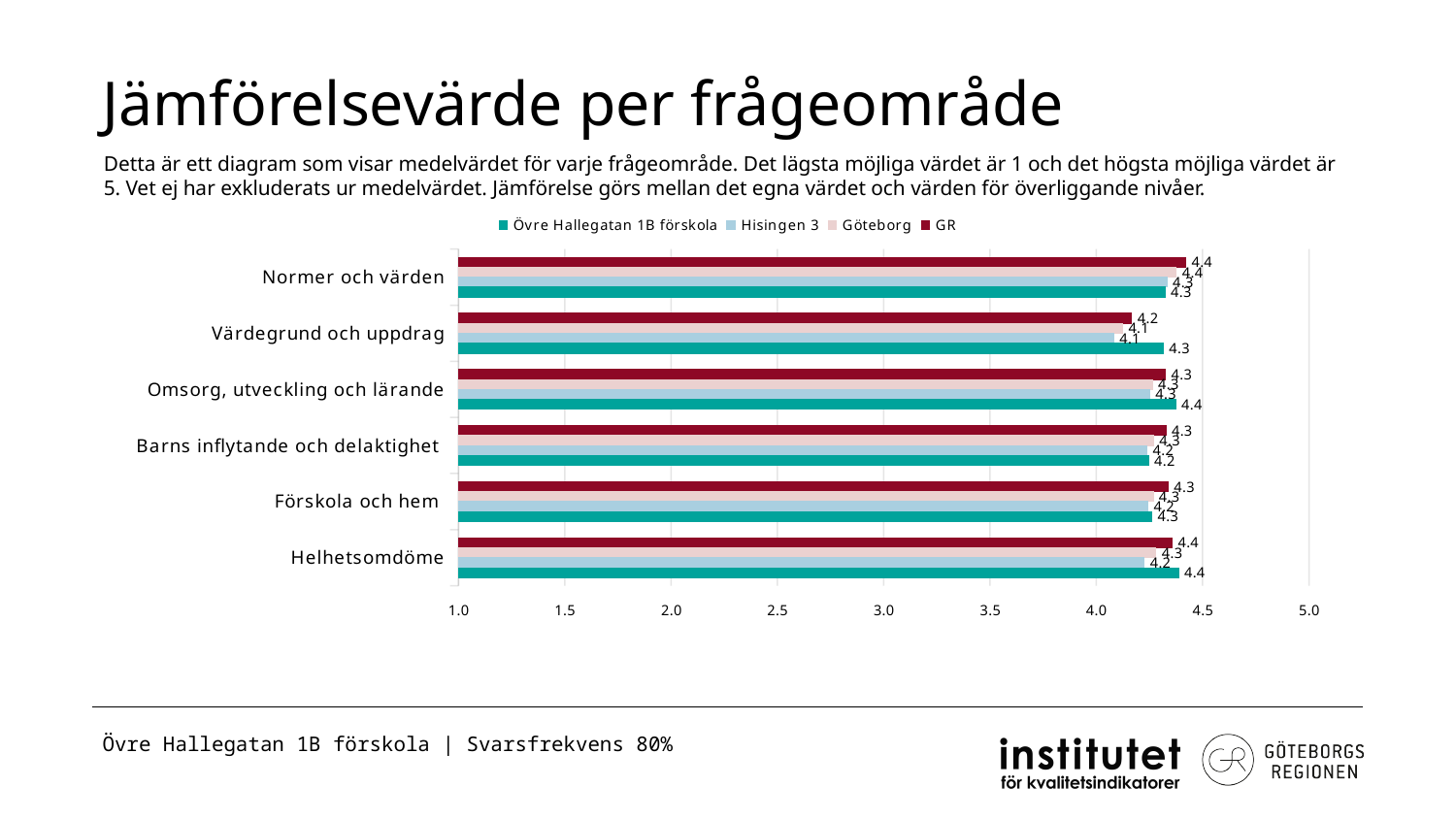
How many series does the legend list? 4 What is the value for Hisingen 3 in the category Helhetsomdöme? 4,2 What is the value for Göteborg in the category Normer och värden? 4,4 What kind of chart is shown on the slide? Bar chart In the category Helhetsomdöme, which is larger: the value for Övre Hallegatan 1B förskola or for Hisingen 3? Övre Hallegatan 1B förskola How many categories (frågeområden) are shown on the chart? 6 In the category Värdegrund och uppdrag, what is the difference between the values for Övre Hallegatan 1B förskola and Göteborg? 0,2 In which category does Övre Hallegatan 1B förskola have its lowest value? Barns inflytande och delaktighet Is the value for GR in the category Helhetsomdöme greater or less than 4.5? less What is the value for Övre Hallegatan 1B förskola in the category Värdegrund och uppdrag? 4,3 What is the highest value shown on the x axis of the chart? 5.0 What is the value for GR in the category Värdegrund och uppdrag? 4,2